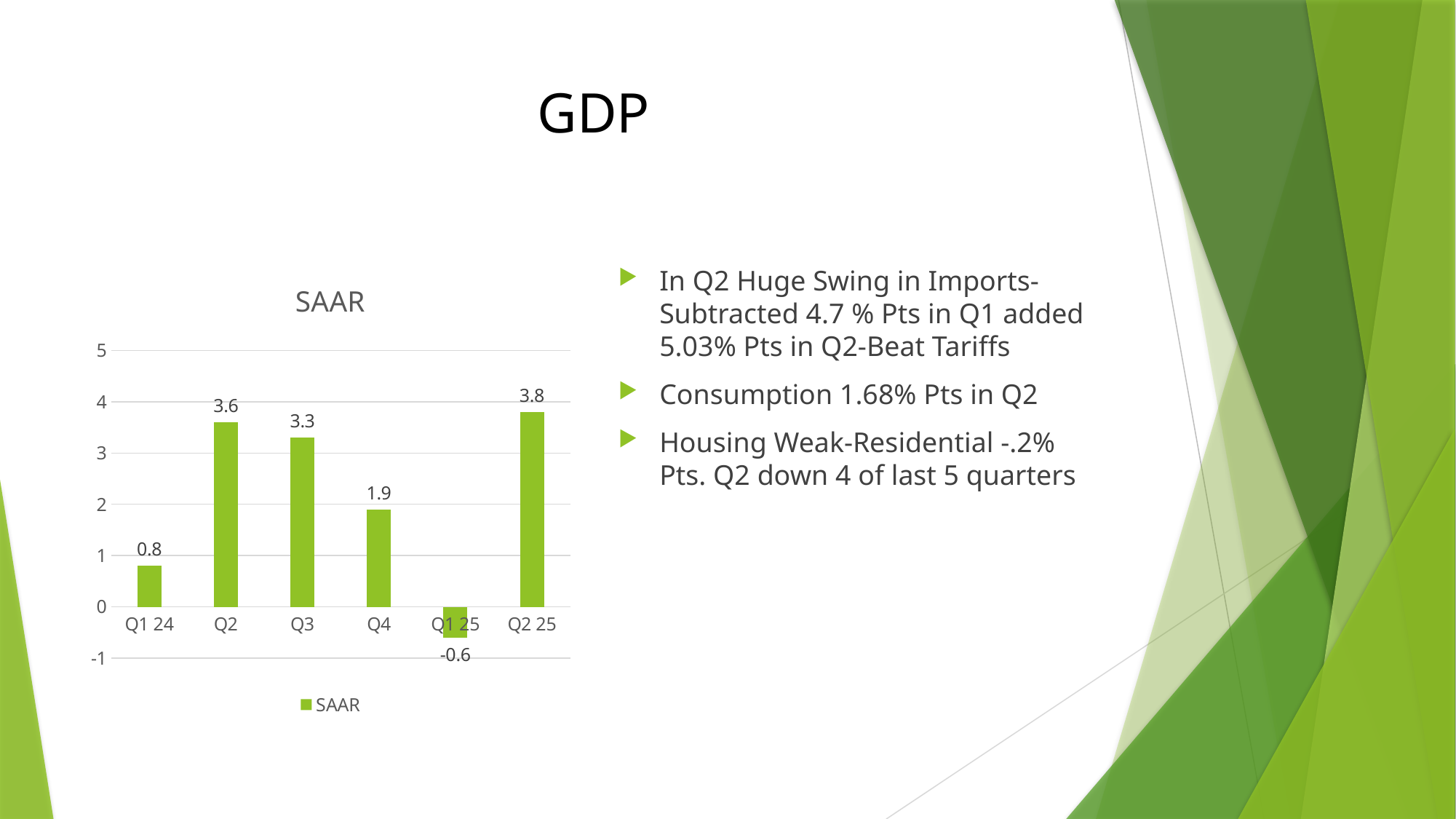
What is the SAAR value for Q1 25? -0.6 What is the difference between the SAAR values for Q2 and Q3? 0.3 What is the title of the chart? SAAR Which is larger, the SAAR value for Q3 or for Q4? Q3 What is the SAAR value for Q1 24? 0.8 What is the difference between the SAAR values for Q2 25 and Q1 25? 4.4 What kind of chart is shown on the slide? Bar chart Which quarter has the highest SAAR value? Q2 25 How many quarters are shown on the chart? 6 Is the SAAR value for Q2 greater or less than 3? greater What is the SAAR value for Q4? 1.9 Which quarter has the lowest SAAR value? Q1 25